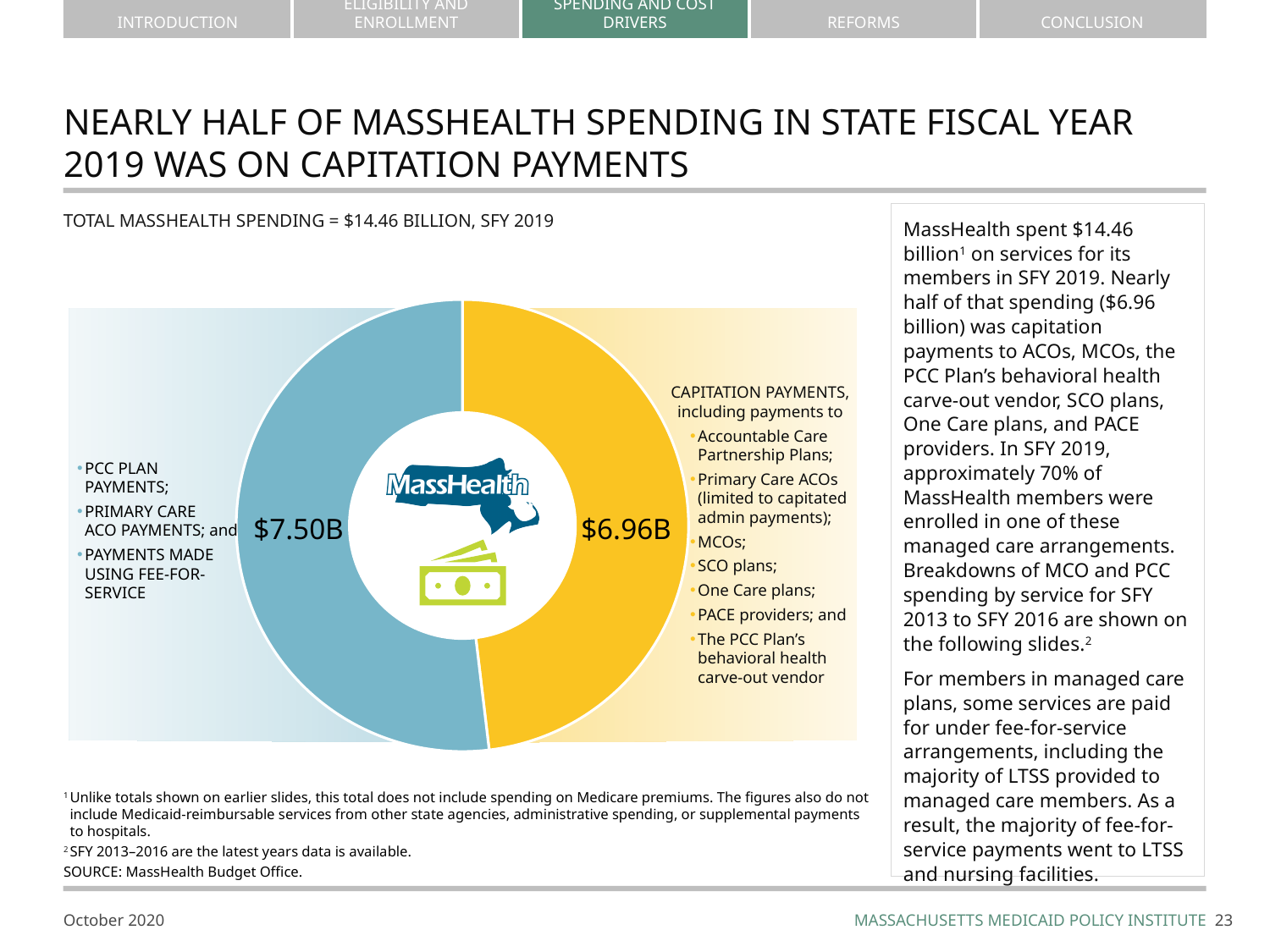
What fiscal year does the chart's spending data refer to? SFY 2019 What kind of chart is shown on the slide? Donut (pie) chart What is the total MassHealth spending shown for SFY 2019? $14.46 billion What is the difference between the $7.50B segment and the $6.96B segment? $0.54B Which segment of the chart is larger: capitation payments or the PCC plan/primary care ACO/fee-for-service segment? PCC plan/primary care ACO/fee-for-service segment ($7.50B) Which segment of the chart has the smallest value? Capitation payments ($6.96B) What is the value shown for the segment covering PCC plan payments, primary care ACO payments, and fee-for-service payments? $7.50B How many segments does the donut chart have? 2 Is the value of the capitation payments segment greater or less than $7B? less What is the value shown for the capitation payments segment of the donut chart? $6.96B What colour is the capitation payments segment of the chart? Yellow